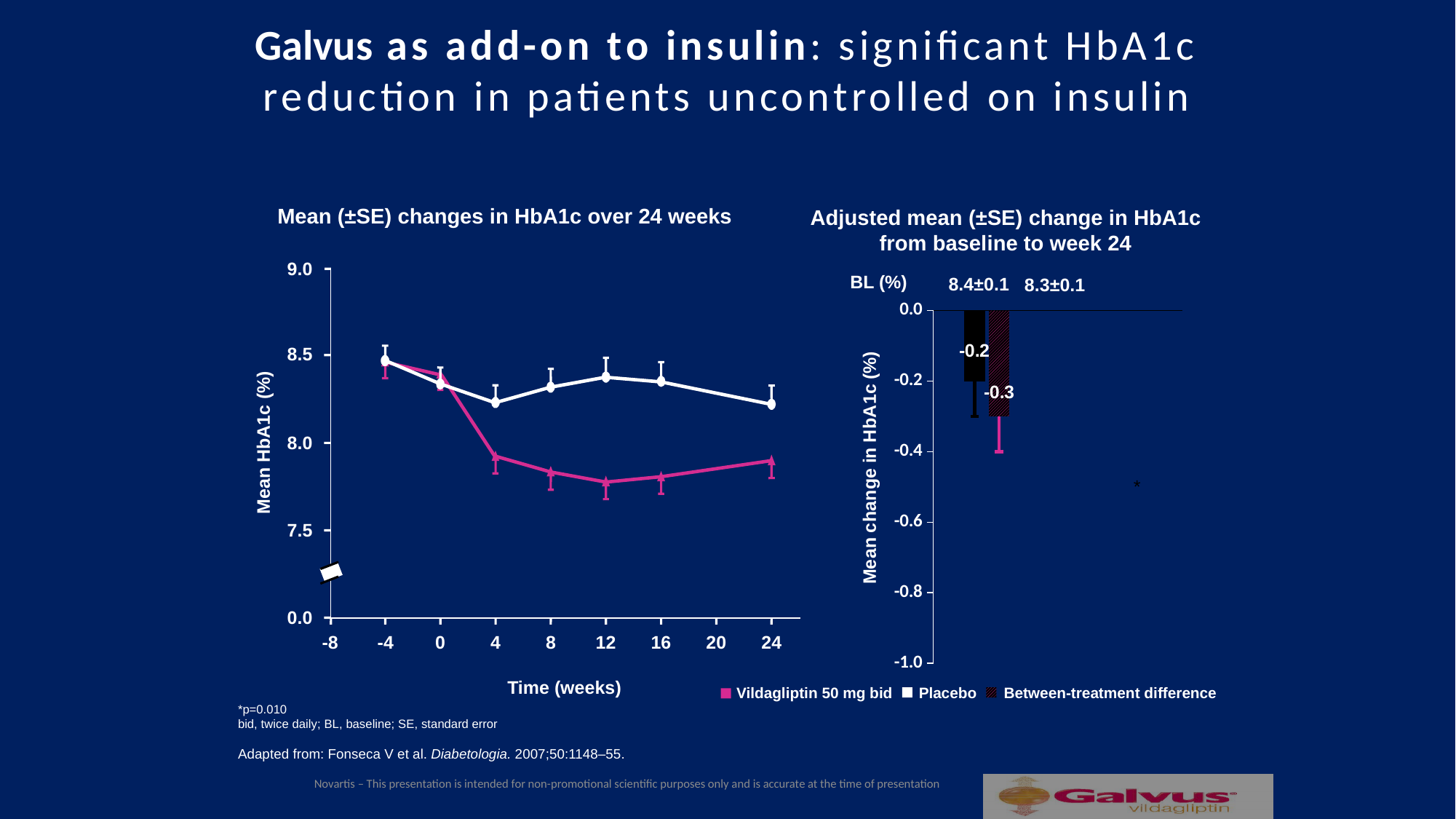
In the right bar chart, what value is printed on the left (solid) bar? -0.2 In the left line chart, does the Vildagliptin 50 mg bid line rise or fall between week 0 and week 12? Fall How many entries does the legend at the bottom of the slide list? 3 In the right bar chart, what value is printed on the hatched Between-treatment difference bar? -0.3 In the right bar chart, what two BL (%) values are printed above the bars? 8.4±0.1 and 8.3±0.1 What is the x-axis label of the left line chart? Time (weeks) In the left line chart, is the Placebo value at week 16 greater or less than 8.0? greater In the left line chart, how many time points are plotted for each series? 7 In the left line chart, is the Vildagliptin 50 mg bid value at week 12 greater or less than 8.0? less What kind of chart is the right chart titled 'Adjusted mean (±SE) change in HbA1c from baseline to week 24'? Bar chart In the left line chart, at week 24, which series has the higher mean HbA1c: Vildagliptin 50 mg bid or Placebo? Placebo What kind of chart is the left chart titled 'Mean (±SE) changes in HbA1c over 24 weeks'? Line chart